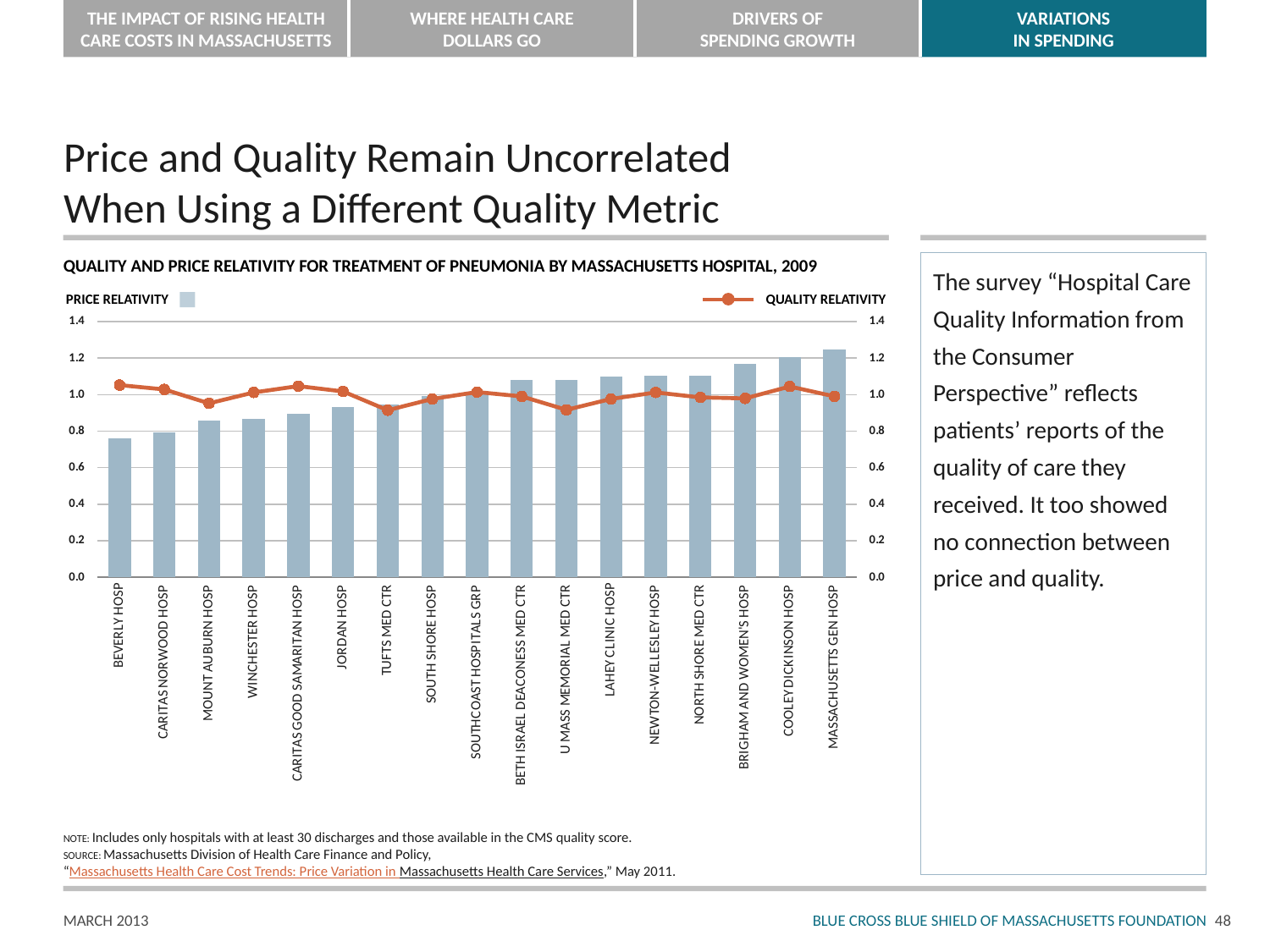
What kind of chart is shown on the slide? A combined bar and line chart How many series does the chart's legend list? 2 Is the price relativity for Massachusetts Gen Hosp greater or less than 1.2? greater Is the price relativity for Beverly Hosp greater or less than 0.8? less Which hospital has the highest price relativity? Massachusetts Gen Hosp Which hospital has the lowest price relativity? Beverly Hosp Which has the higher price relativity, Jordan Hosp or Brigham and Women's Hosp? Brigham and Women's Hosp Is the quality relativity for Tufts Med Ctr greater or less than 1.0? less How many hospitals are shown along the x axis of the chart? 17 What is the title of the chart? Quality and Price Relativity for Treatment of Pneumonia by Massachusetts Hospital, 2009 Do the price relativity bars rise or fall moving from left to right across the chart? rise